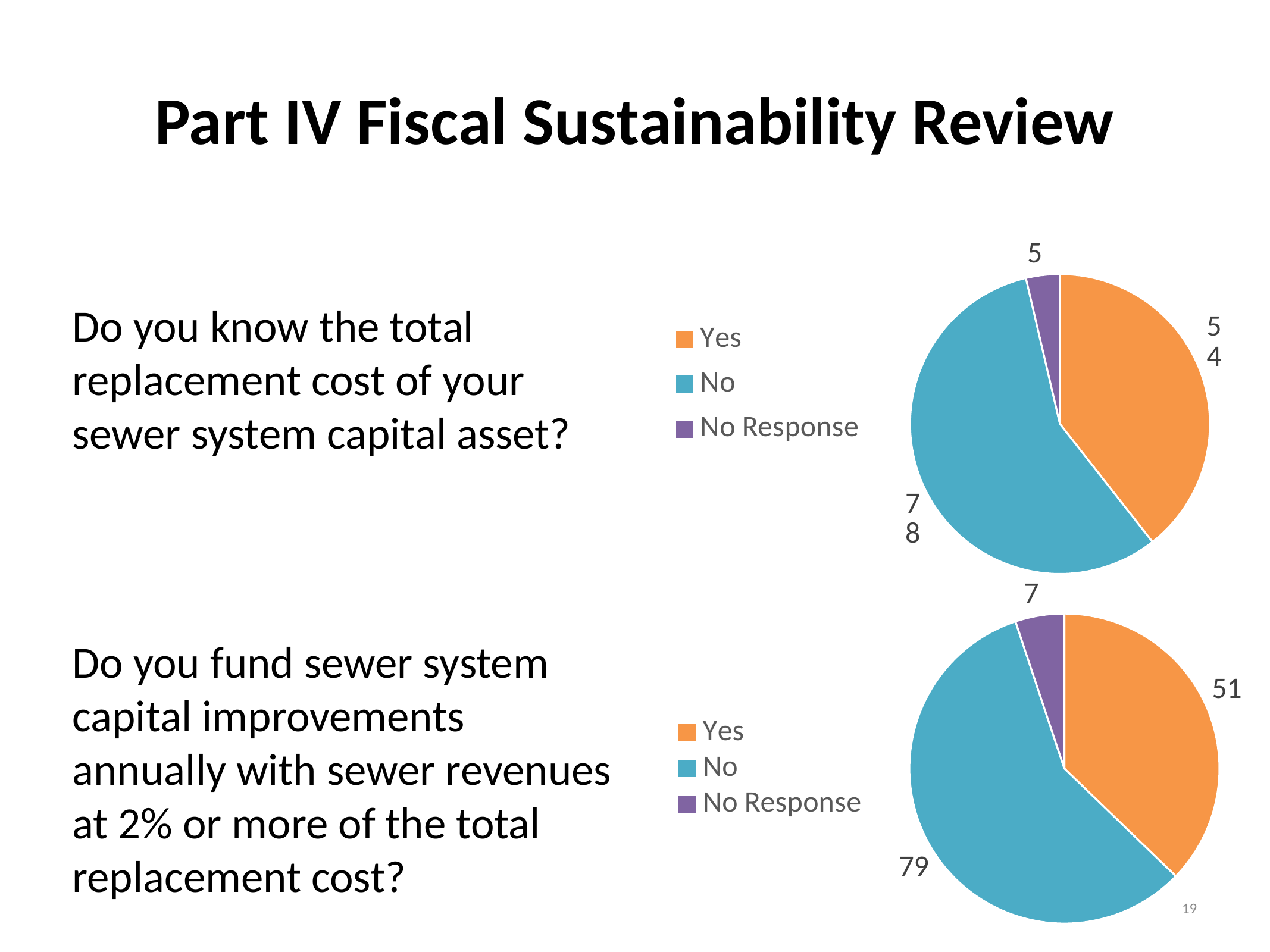
What type of chart is used for the question about funding sewer system capital improvements? Pie chart How many categories does the legend of the top pie chart list? 3 In the top pie chart (knowing total replacement cost), which category has the largest slice? No In the bottom pie chart (funding capital improvements at 2% or more), what is the value for No? 79 In the top pie chart (knowing total replacement cost), what is the value for No Response? 5 In the bottom pie chart (funding capital improvements at 2% or more), what is the value for No Response? 7 In the bottom pie chart (funding capital improvements at 2% or more), which is larger, Yes or No? No In the bottom pie chart, what colour represents No Response? Purple In the bottom pie chart (funding capital improvements at 2% or more), what is the difference between No and Yes? 28 In the bottom pie chart (funding capital improvements at 2% or more), which category has the smallest slice? No Response In the bottom pie chart (funding capital improvements at 2% or more), what is the value for Yes? 51 In the top pie chart (knowing total replacement cost), what is the value for No? 78